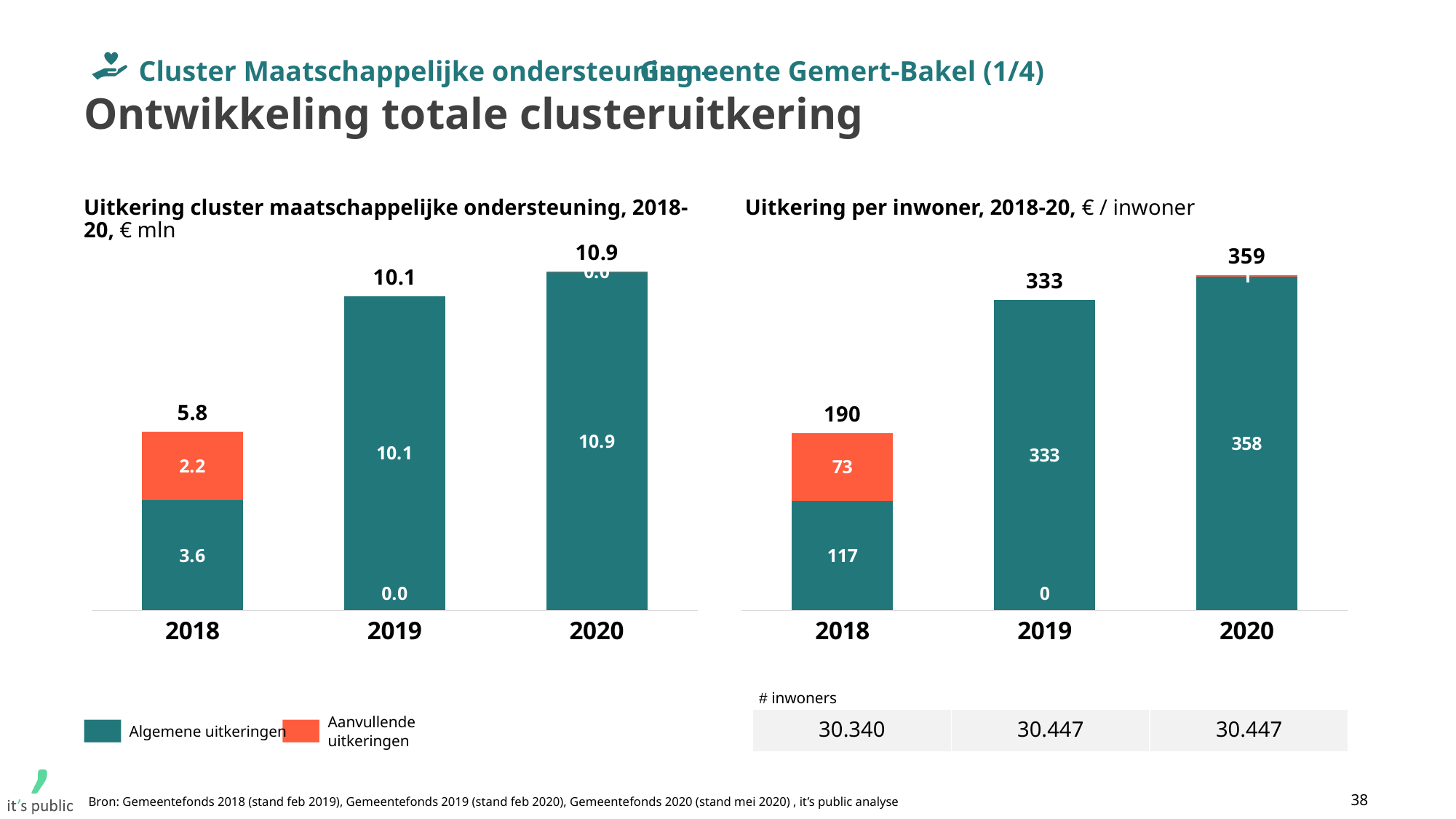
In the right chart (Uitkering per inwoner), what is the value of Algemene uitkeringen in 2020? 358 In the left chart (Uitkering cluster maatschappelijke ondersteuning), which year has the highest total? 2020 In the left chart (Uitkering cluster maatschappelijke ondersteuning), what is the difference between the 2020 total and the 2019 total? 0.8 How many series does the legend list for the left chart? 2 In the left chart (Uitkering cluster maatschappelijke ondersteuning), what is the total value of the 2018 bar? 5.8 In the left chart (Uitkering cluster maatschappelijke ondersteuning), what is the value of Aanvullende uitkeringen in 2018? 2.2 In the right chart (Uitkering per inwoner), what is the total for 2019? 333 In the left chart (Uitkering cluster maatschappelijke ondersteuning), what is the value of Algemene uitkeringen in 2019? 10.1 In the right chart (Uitkering per inwoner), what is the difference between the 2020 total and the 2018 total? 169 In the right chart (Uitkering per inwoner), what is the value of Aanvullende uitkeringen in 2018? 73 In the right chart (Uitkering per inwoner), which year has the lowest total? 2018 What kind of chart is the left chart (Uitkering cluster maatschappelijke ondersteuning)? Stacked bar chart